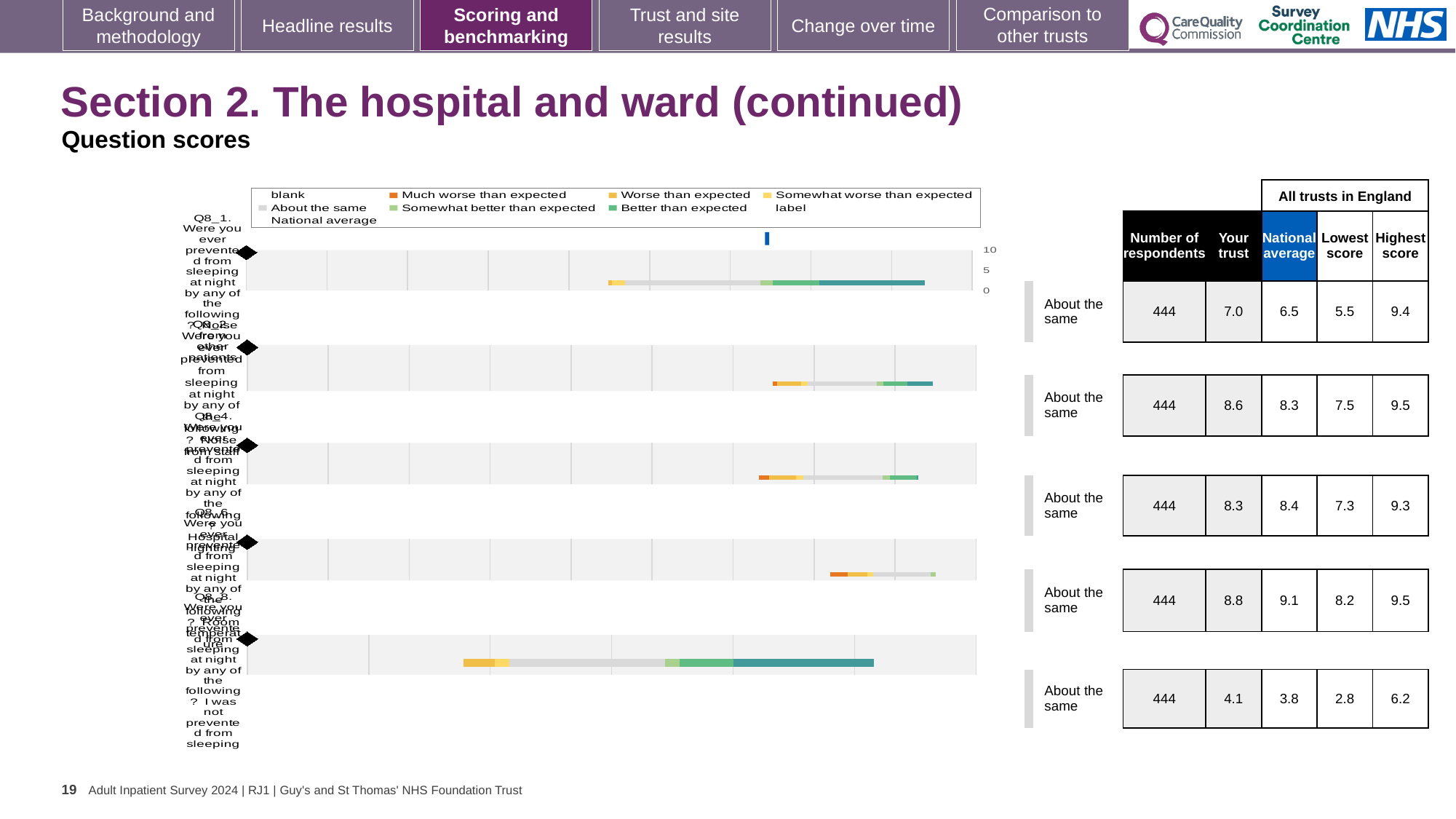
In the table beside the chart, what is the highest score for the second row (Q8_2)? 9.5 Which legend entry is shown in the dark teal colour in the chart? Better than expected What kind of chart is shown on the slide? bar chart In the table beside the chart, what is the number of respondents for the fourth row (Q8_6)? 444 How many question bars (rows) are plotted in the chart? 5 In the table beside the chart, what is the national average for the last row (Q8_8)? 3.8 How many of the chart's rows are rated 'About the same'? 5 In the table beside the chart, which row has the highest 'Your trust' score? Q8_6 In the table beside the chart, which row has the lowest 'Your trust' score? Q8_8 In the table beside the chart, what is the 'Your trust' score for the first row (Q8_1)? 7.0 In the table beside the chart, what is the difference between the 'Your trust' score and the national average for the first row (Q8_1)? 0.5 Which legend entry is shown in the orange-red colour in the chart? Much worse than expected